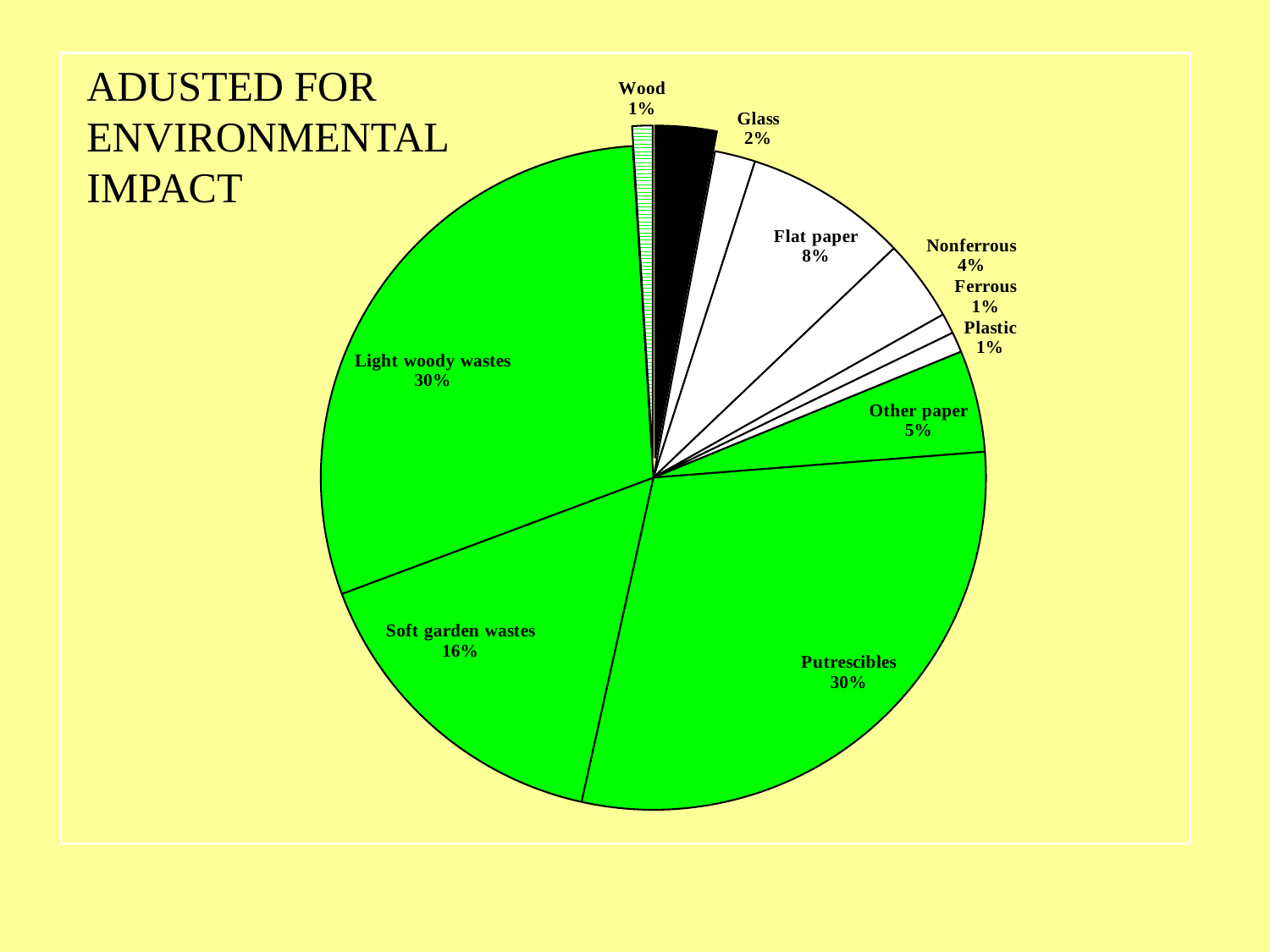
What kind of chart is shown on the slide? Pie chart What share of the pie is Soft garden wastes? 16% What is the difference between the shares of Flat paper and Other paper? 3% What is the value shown for Flat paper? 8% How many slices does the pie chart have? 11 What is the title text on the slide? ADUSTED FOR ENVIRONMENTAL IMPACT Which is larger, the share for Nonferrous or the share for Glass? Nonferrous What is the difference between the shares of Light woody wastes and Soft garden wastes? 14% What is the value shown for Nonferrous? 4% What is the value shown for Glass? 2% What is the value shown for Other paper? 5% What share of the pie is Putrescibles? 30%